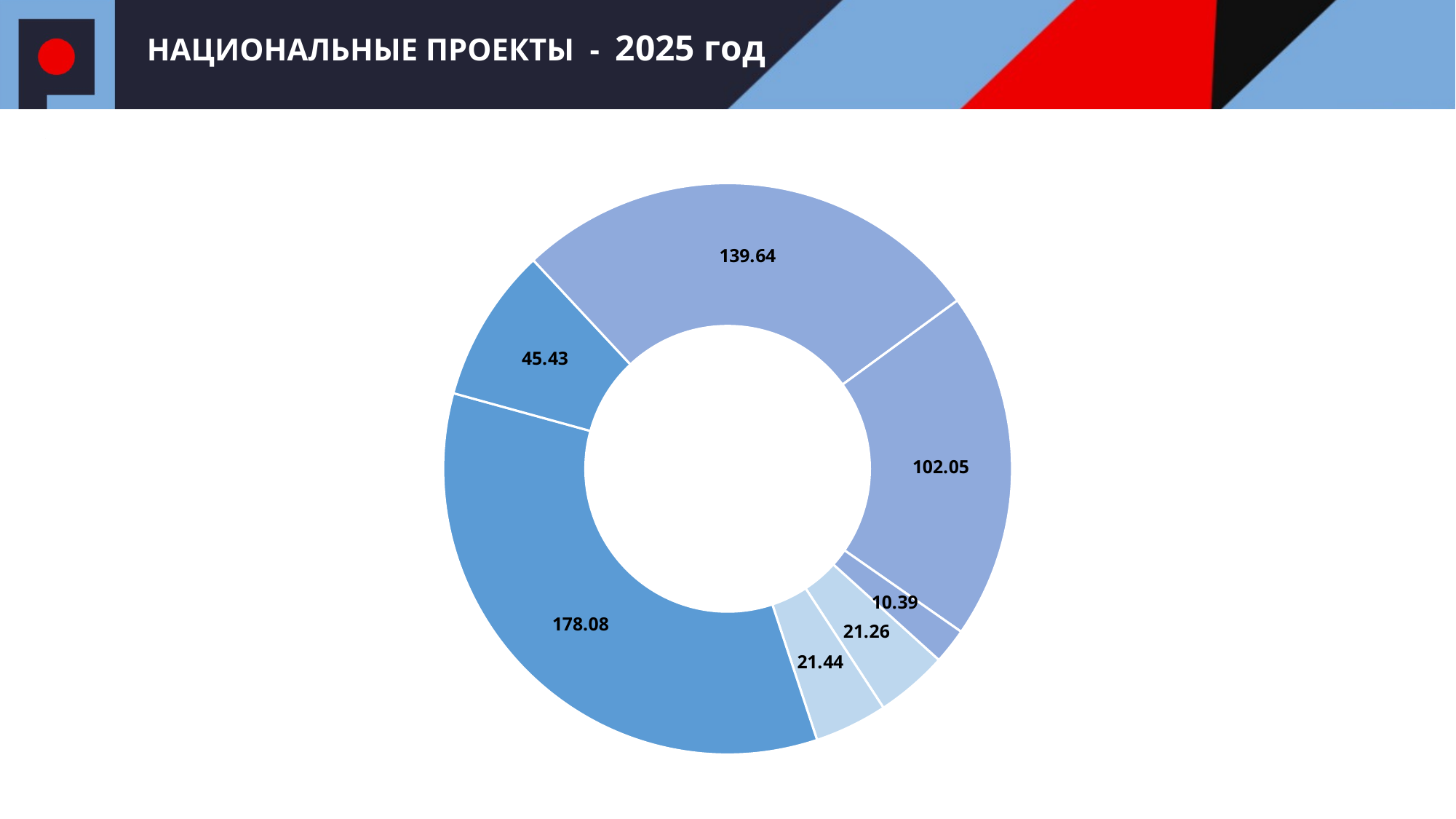
What is the value of the second-largest slice in the doughnut chart? 139.64 How many slices does the doughnut chart contain? 7 What is the difference between the slice labelled 139.64 and the slice labelled 102.05? 37.59 What is the total of all slice values shown in the doughnut chart? 518.29 What is the value of the smallest slice in the doughnut chart? 10.39 What is the difference between the largest slice (178.08) and the smallest slice (10.39)? 167.69 What kind of chart is shown on the slide? Doughnut (pie) chart Which is larger: the slice labelled 45.43 or the slice labelled 21.44? 45.43 What is the title of the slide containing the chart? НАЦИОНАЛЬНЫЕ ПРОЕКТЫ - 2025 год Does the doughnut chart display a legend? No Which is larger: the slice labelled 139.64 or the slice labelled 102.05? 139.64 What is the value of the largest slice in the doughnut chart? 178.08